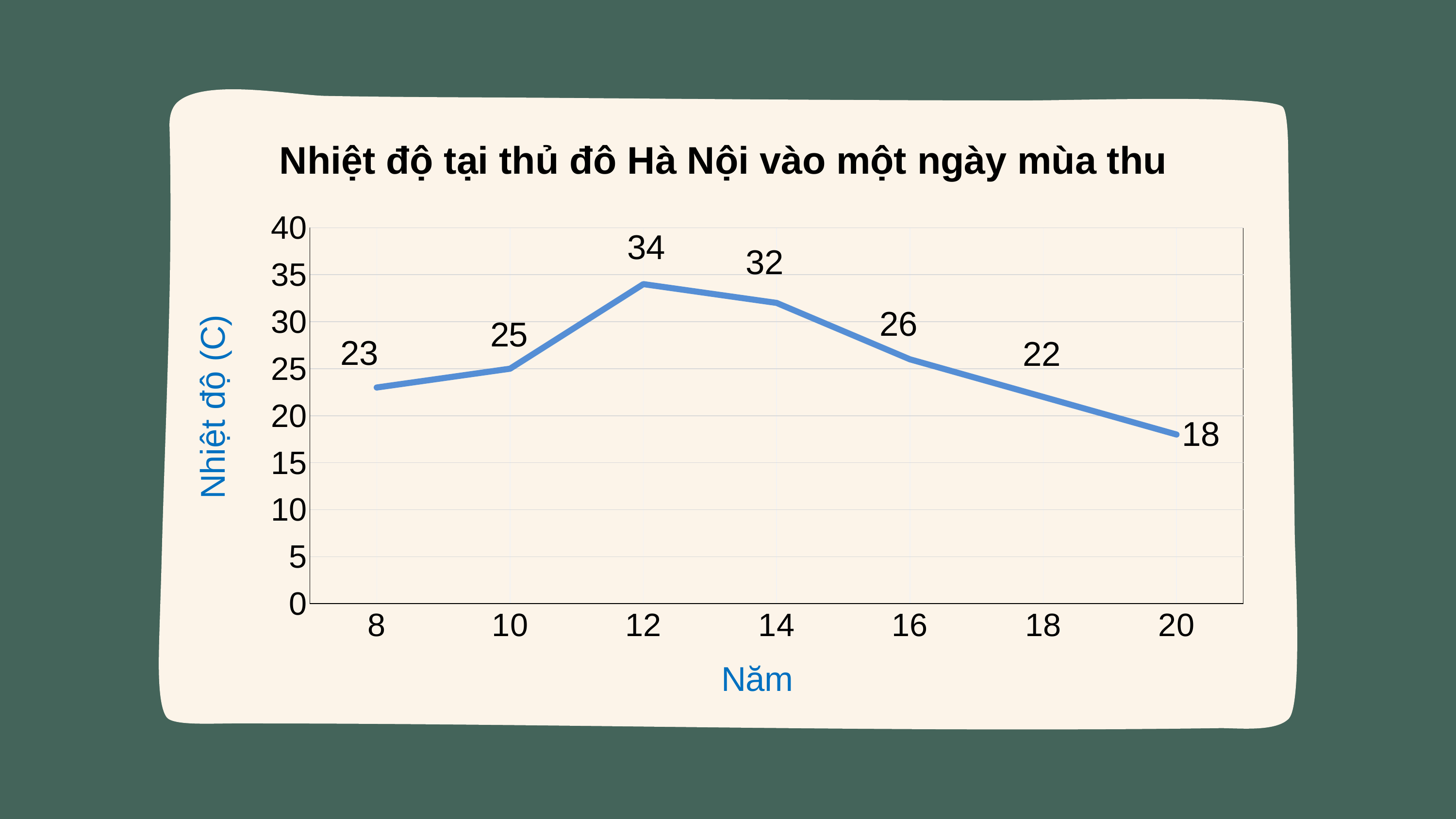
Which is larger, the temperature at 10 or the temperature at 16? 16 At which x-axis value is the temperature lowest? 20 How many data points are plotted on the chart? 7 What is the temperature at 20? 18 What kind of chart is shown on the slide? line chart What is the temperature at 8? 23 What is the title of the chart? Nhiệt độ tại thủ đô Hà Nội vào một ngày mùa thu At which x-axis value is the temperature highest? 12 What is the difference between the temperature at 12 and the temperature at 20? 16 What is the temperature at 12 on the chart? 34 Is the temperature at 14 greater or less than 30? greater Do the values rise or fall from 12 to 20 along the x axis? fall